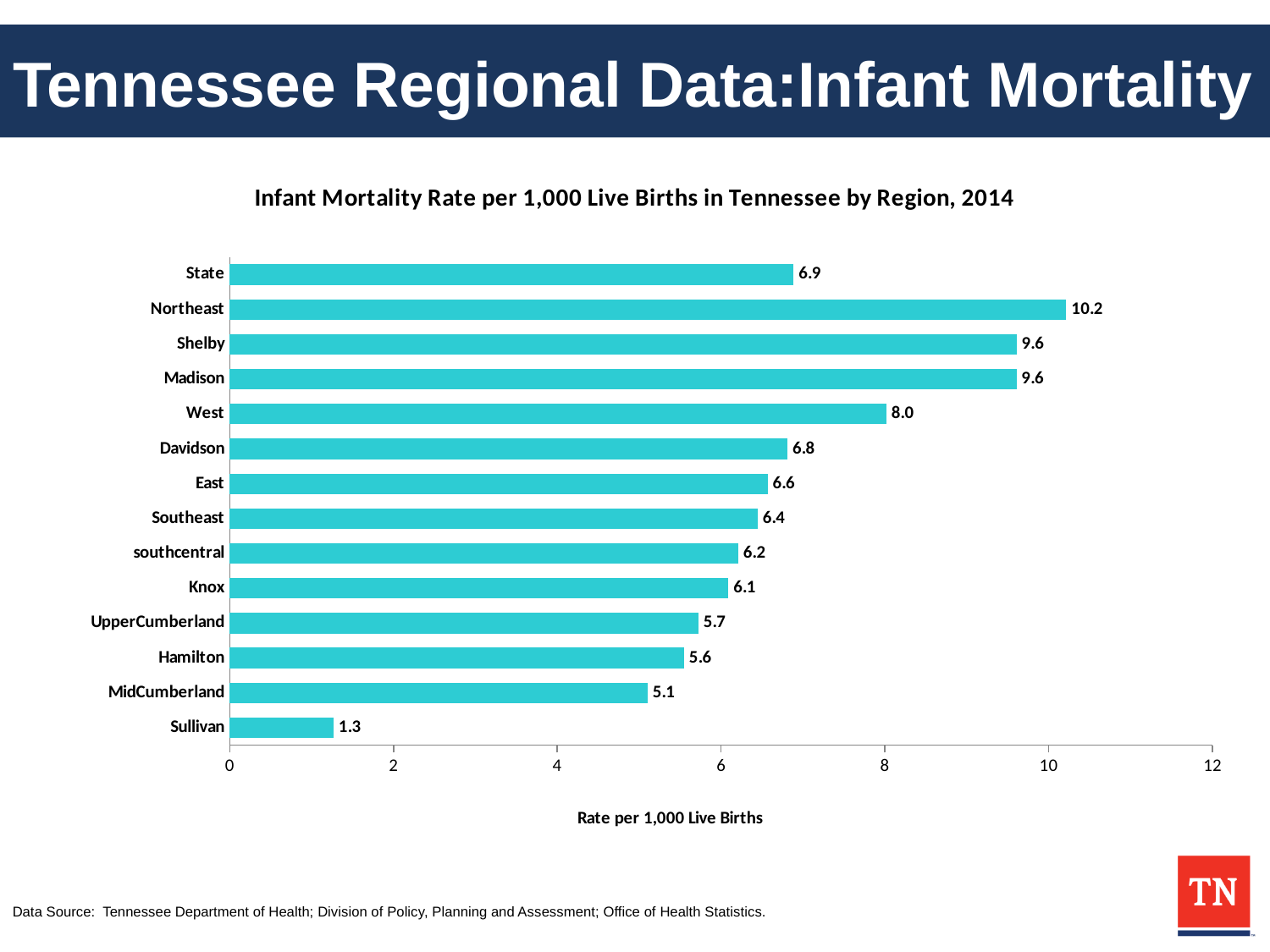
What kind of chart is shown on the slide? Bar chart Which region has the lowest infant mortality rate? Sullivan Which region has the highest infant mortality rate? Northeast What is the difference between the infant mortality rates of Northeast and Sullivan? 8.9 What is the label on the horizontal axis of the chart? Rate per 1,000 Live Births How many bars are shown in the chart? 14 What is the infant mortality rate for Sullivan? 1.3 What is the infant mortality rate for the Northeast region? 10.2 What is the infant mortality rate for the State overall? 6.9 Which has a higher infant mortality rate, Hamilton or MidCumberland? Hamilton What is the difference between the infant mortality rates of West and Davidson? 1.2 Is the infant mortality rate for Shelby greater or less than 8? greater